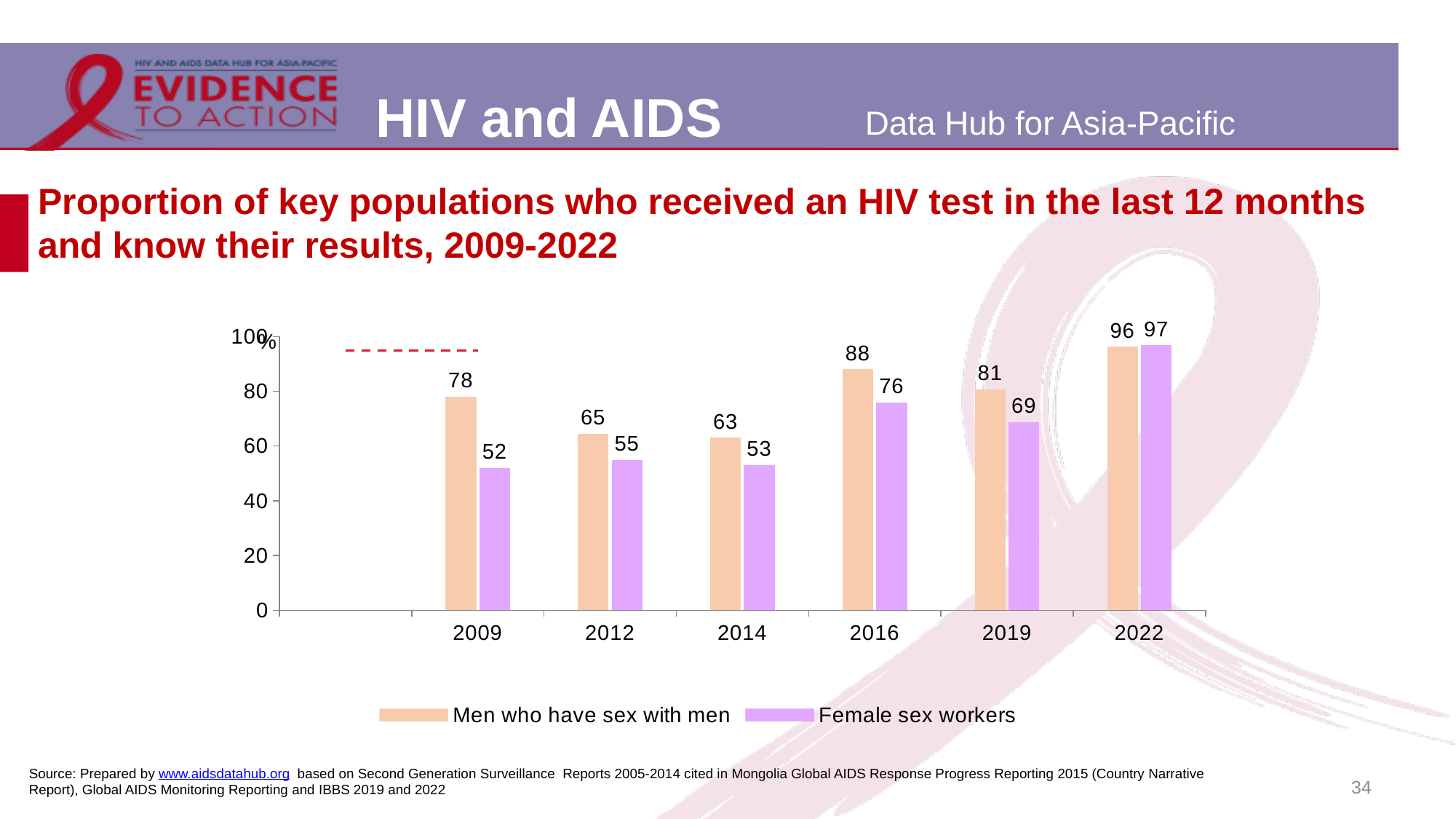
Which legend entry is shown in purple? Female sex workers How many series does the legend list? 2 What is the value for Men who have sex with men in 2009? 78 Which series has the larger value in 2019, Men who have sex with men or Female sex workers? Men who have sex with men What kind of chart is shown on the slide? Bar chart In which year is the value for Men who have sex with men the highest? 2022 What is the value for Female sex workers in 2016? 76 Does the value for Female sex workers rise or fall from 2019 to 2022? Rise In which year is the value for Female sex workers the lowest? 2009 What is the difference between the Men who have sex with men and Female sex workers values in 2009? 26 How many years are shown on the x axis? 6 What is the value for Female sex workers in 2022? 97